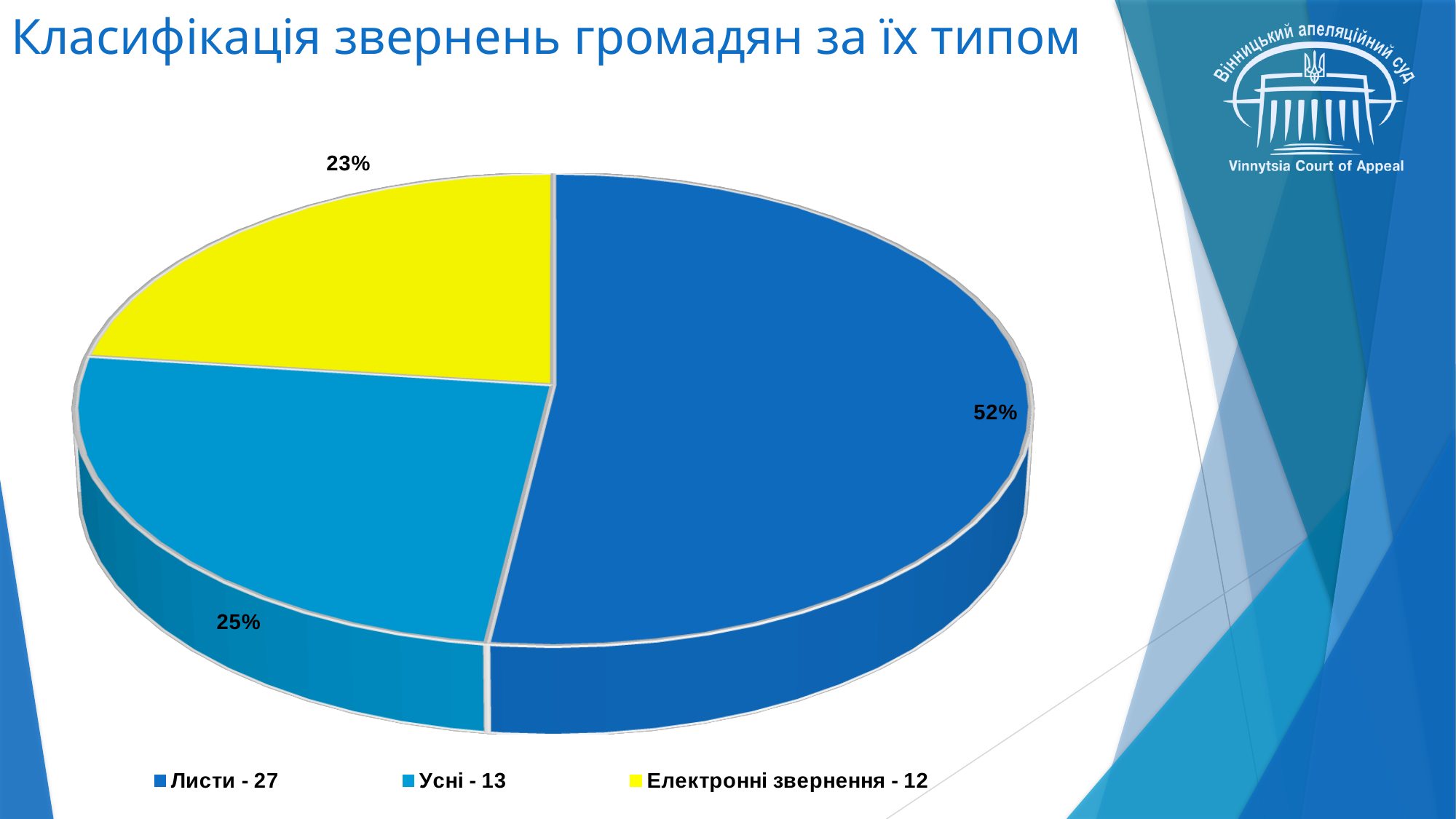
What is the title of the slide containing the pie chart? Класифікація звернень громадян за їх типом What type of chart is shown on the slide? pie chart Which category has the largest slice of the pie? Листи - 27 How many entries does the legend list? 3 What is the difference in percentage points between the "Листи" slice and the "Усні" slice? 27 Which slice is larger, "Усні - 13" or "Електронні звернення - 12"? Усні - 13 What percentage share is shown for the "Електронні звернення - 12" slice? 23% What percentage share is shown for the "Листи - 27" slice? 52% How many slices does the pie chart have? 3 What colour is the "Електронні звернення - 12" slice? yellow What percentage share is shown for the "Усні - 13" slice? 25% Which category has the smallest slice of the pie? Електронні звернення - 12